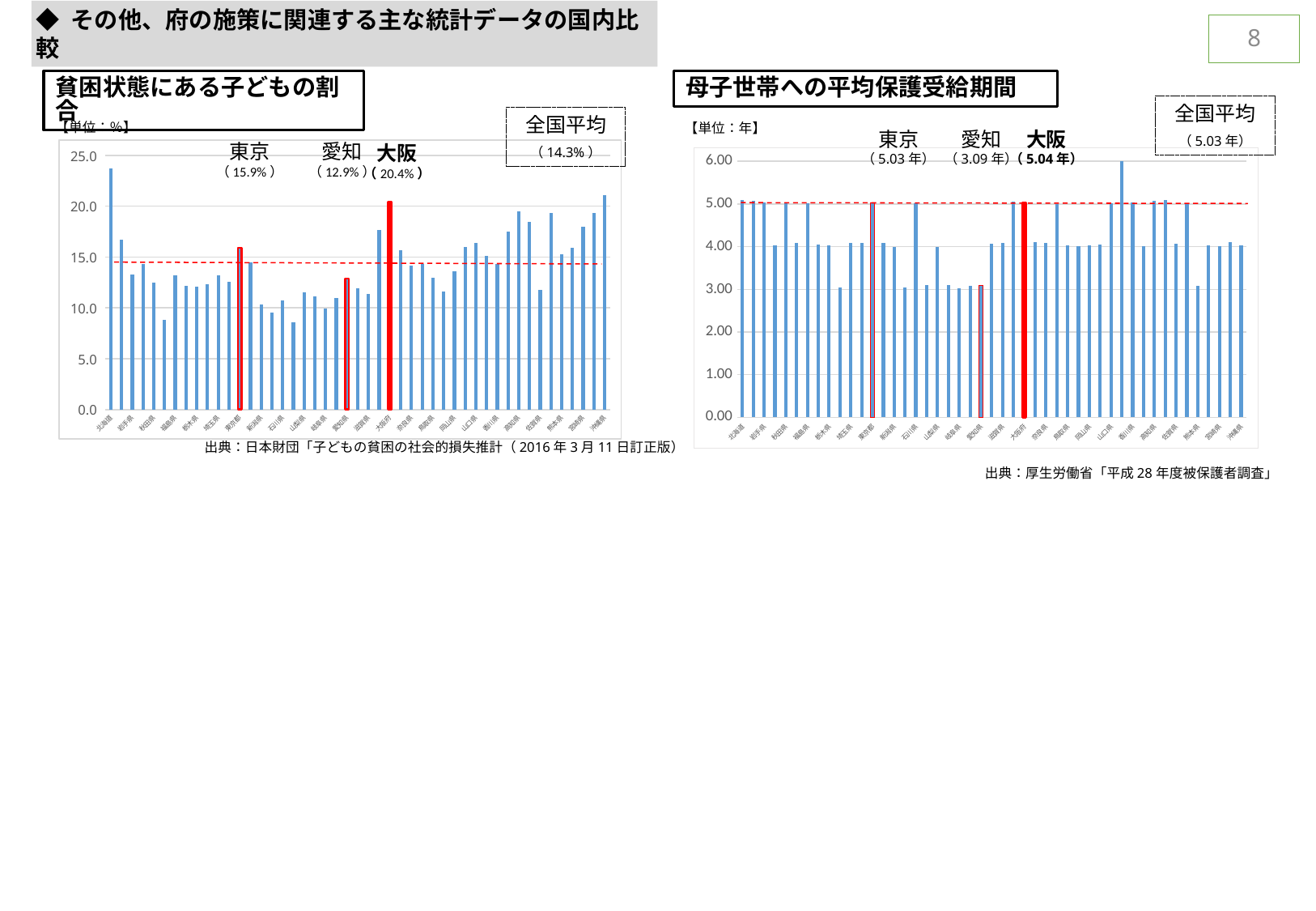
On the left chart (貧困状態にある子どもの割合), what is the value for 愛知? 12.9% On the left chart (貧困状態にある子どもの割合), what is the national average (全国平均) shown? 14.3% On the left chart (貧困状態にある子どもの割合), what is the value for 大阪? 20.4% On the right chart (母子世帯への平均保護受給期間), what is the value for 愛知? 3.09年 On the right chart (母子世帯への平均保護受給期間), what is the national average (全国平均) shown? 5.03年 On the right chart (母子世帯への平均保護受給期間), what is the value for 大阪? 5.04年 What kind of chart is the right chart (母子世帯への平均保護受給期間)? bar chart On the left chart (貧困状態にある子どもの割合), which is larger, the value for 大阪 or the national average? 大阪 On the left chart (貧困状態にある子どもの割合), is the value for 北海道 greater or less than 20.0? greater On the right chart (母子世帯への平均保護受給期間), what is the difference between 大阪 and 愛知? 1.95年 On the left chart (貧困状態にある子どもの割合), what is the value for 東京? 15.9% On the left chart (貧困状態にある子どもの割合), how much higher is 大阪 than 東京? 4.5 percentage points